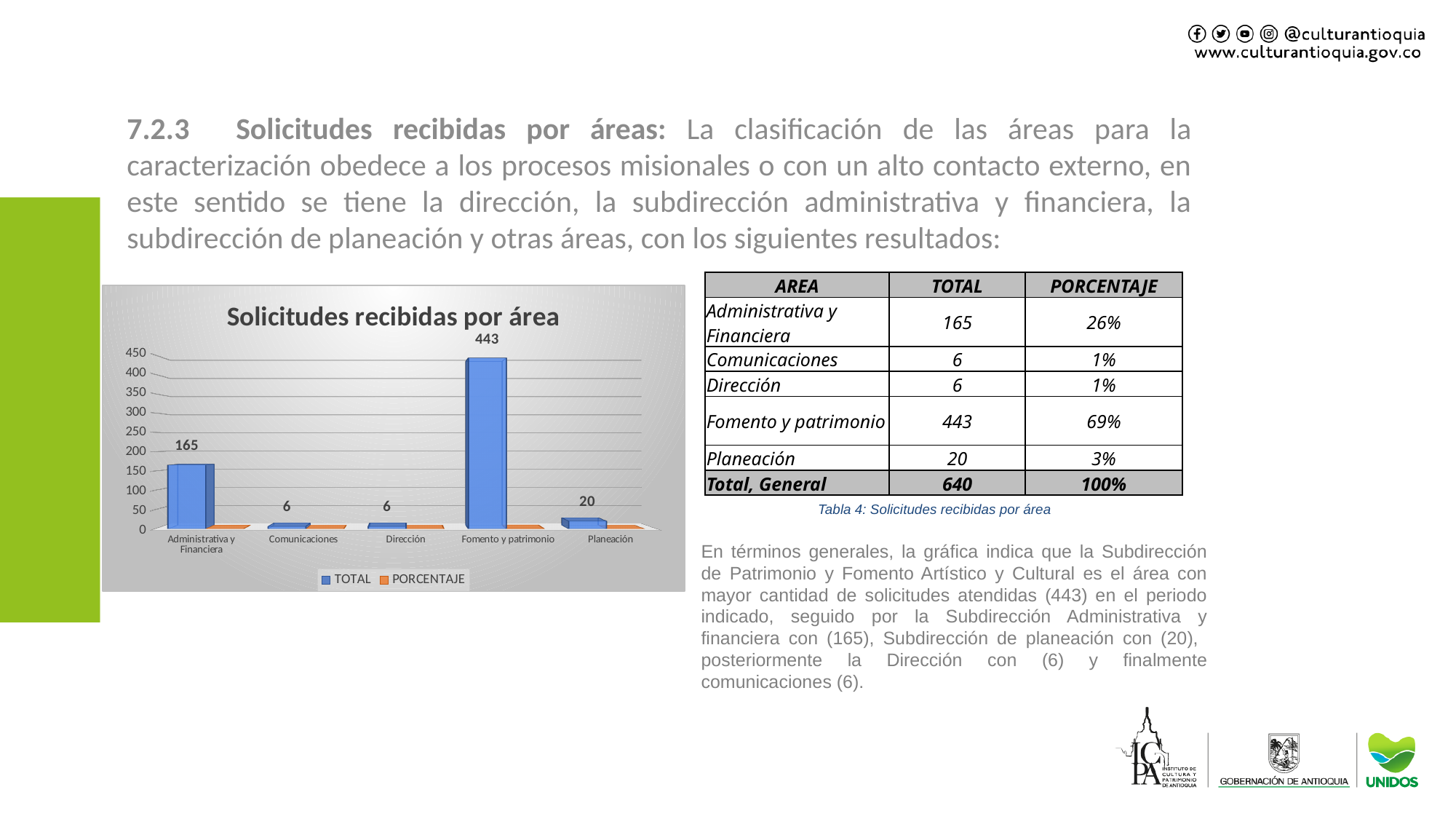
How many categories are shown on the x axis of the chart? 5 Is the TOTAL value for Administrativa y Financiera greater or less than 200? less What is the TOTAL value for Fomento y patrimonio in the chart? 443 What is the title of the chart? Solicitudes recibidas por área What is the TOTAL value for Comunicaciones in the chart? 6 How many series does the chart legend list? 2 Which is larger, the TOTAL for Planeación or the TOTAL for Dirección? Planeación What is the TOTAL value for Administrativa y Financiera in the chart? 165 Which category has the highest TOTAL in the chart? Fomento y patrimonio What is the difference between the TOTAL for Fomento y patrimonio and the TOTAL for Administrativa y Financiera? 278 What is the TOTAL value for Planeación in the chart? 20 What type of chart is shown on the slide? bar chart